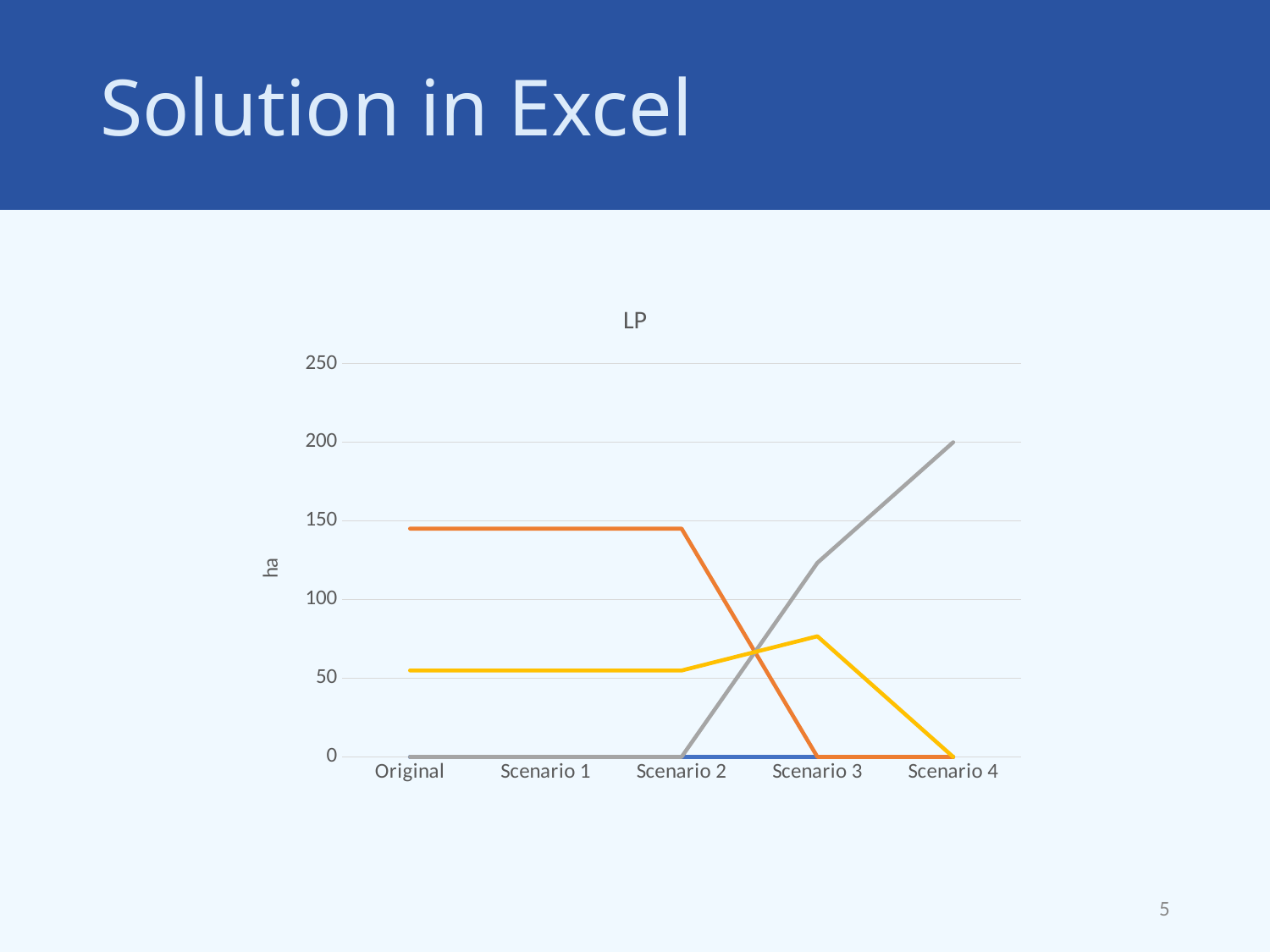
What is the label on the vertical axis of the chart? ha At which category does the gray line reach its highest value? Scenario 4 What is the title of the chart? LP At Original, which line has the larger value, the orange line or the yellow line? orange line How many categories are shown along the x axis of the chart? 5 Is the value of the gray line at Scenario 3 greater or less than 100? greater What is the value of the gray line at Scenario 4? 200 What is the value of the orange line at Scenario 4? 0 Is the value of the orange line at Original greater or less than 100? greater What type of chart is shown on the slide? line chart Does the gray line rise or fall from Scenario 2 to Scenario 4? rise Is the value of the yellow line at Original greater or less than 100? less